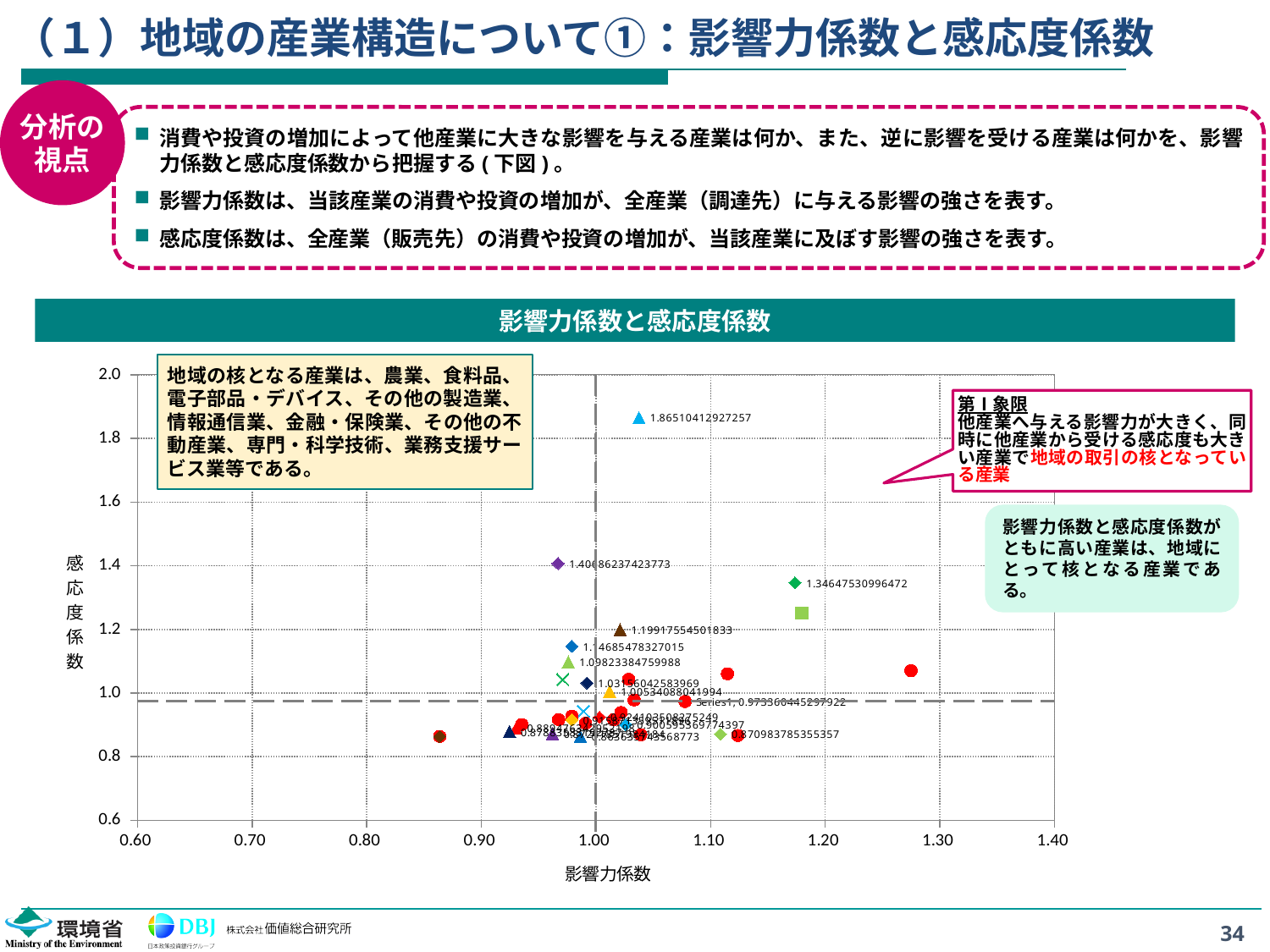
What is the title of the chart? 影響力係数と感応度係数 Is the 感応度係数 of the point labeled 1.19917554501833 greater or less than 1.4? less What kind of chart is shown on the slide? scatter chart What is the maximum value shown on the horizontal axis of the chart? 1.40 Is the 影響力係数 of the point labeled 1.34647530996472 greater or less than 1.10? greater What is the highest 感応度係数 value labeled on the chart? 1.86510412927257 Is the 感応度係数 of the rightmost point on the chart greater or less than 1.0? greater What is the difference between the highest labeled value (1.86510412927257) and the second-highest labeled value (1.40686237423773)? 0.45824175503484 What is the label of the horizontal axis of the chart? 影響力係数 Which point has the higher 感応度係数, the one labeled 1.40686237423773 or the one labeled 1.34647530996472? 1.40686237423773